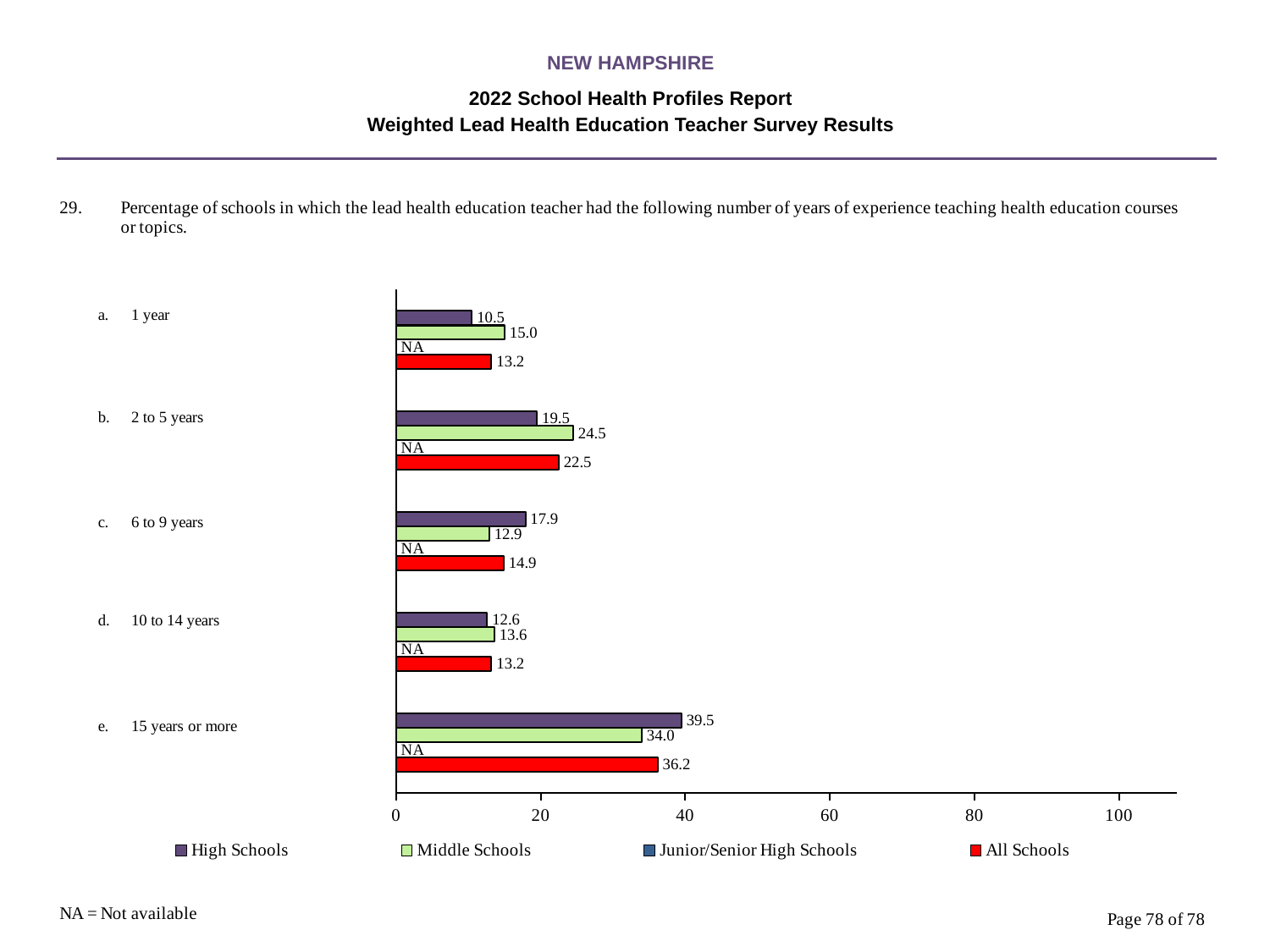
Which category has the highest value for All Schools? 15 years or more Which category has the lowest value for High Schools? 1 year How many categories of years of experience are shown on the chart? 5 What is the value for Middle Schools in the '2 to 5 years' category? 24.5 How many series does the legend list? 4 What is the value for Junior/Senior High Schools in the '1 year' category? NA What is the value for High Schools in the '15 years or more' category? 39.5 What is the value for All Schools in the '6 to 9 years' category? 14.9 In the '6 to 9 years' category, which is larger: the High Schools value or the Middle Schools value? High Schools Is the value for All Schools in the '15 years or more' category greater or less than 40? less What kind of chart is shown on the slide? bar chart What is the difference between the High Schools and Middle Schools values in the '15 years or more' category? 5.5